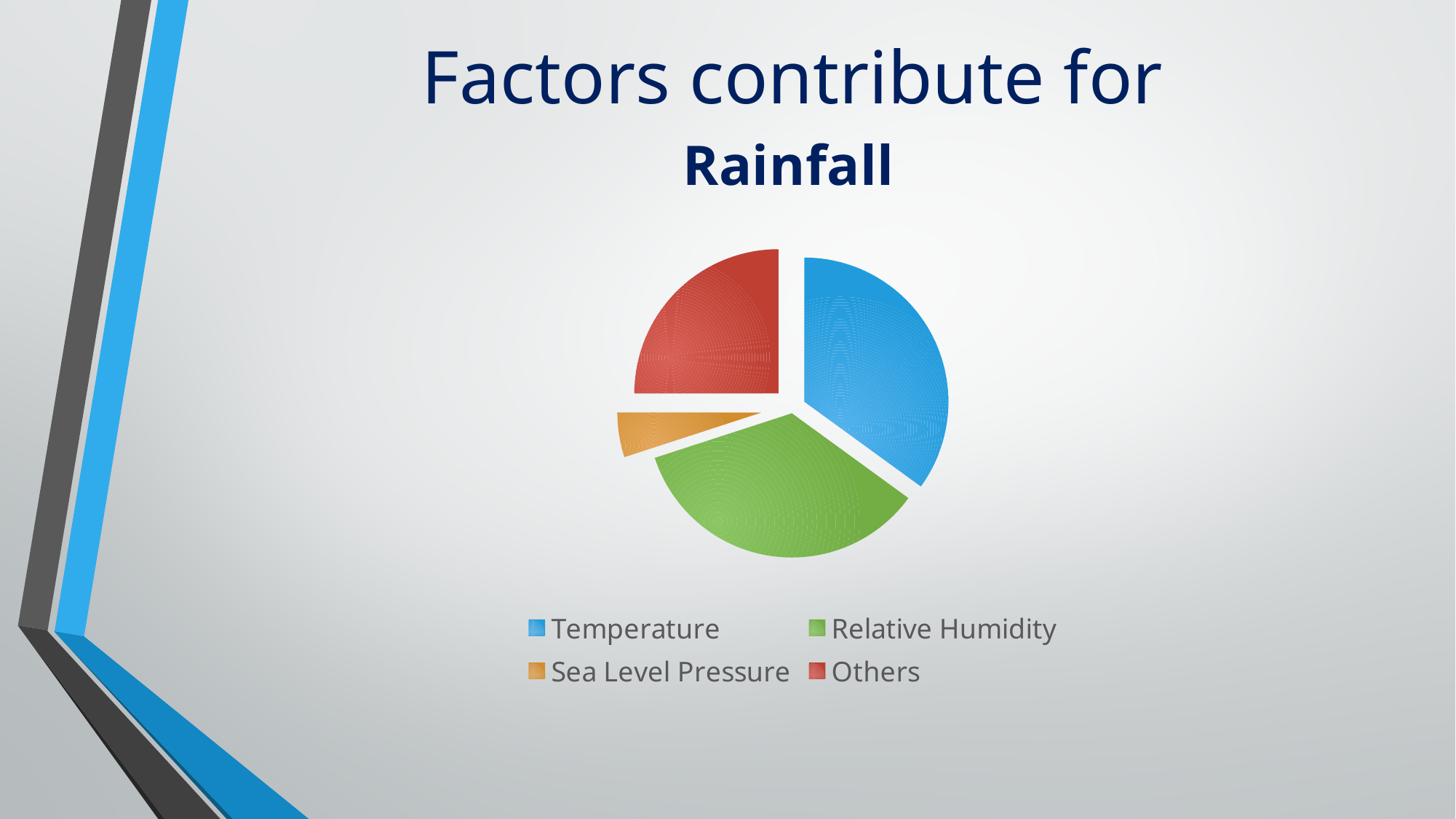
What kind of chart is shown on the slide? pie chart Which slice is larger, Relative Humidity or Others? Relative Humidity What colour is the Others slice in the pie chart? red Which slice is larger, Others or Sea Level Pressure? Others How many entries does the legend of the pie chart list? 4 Which factor has the smallest slice in the pie chart? Sea Level Pressure What is the title shown above the pie chart? Factors contribute for Rainfall Which slice is larger, Temperature or Sea Level Pressure? Temperature How many slices does the pie chart have? 4